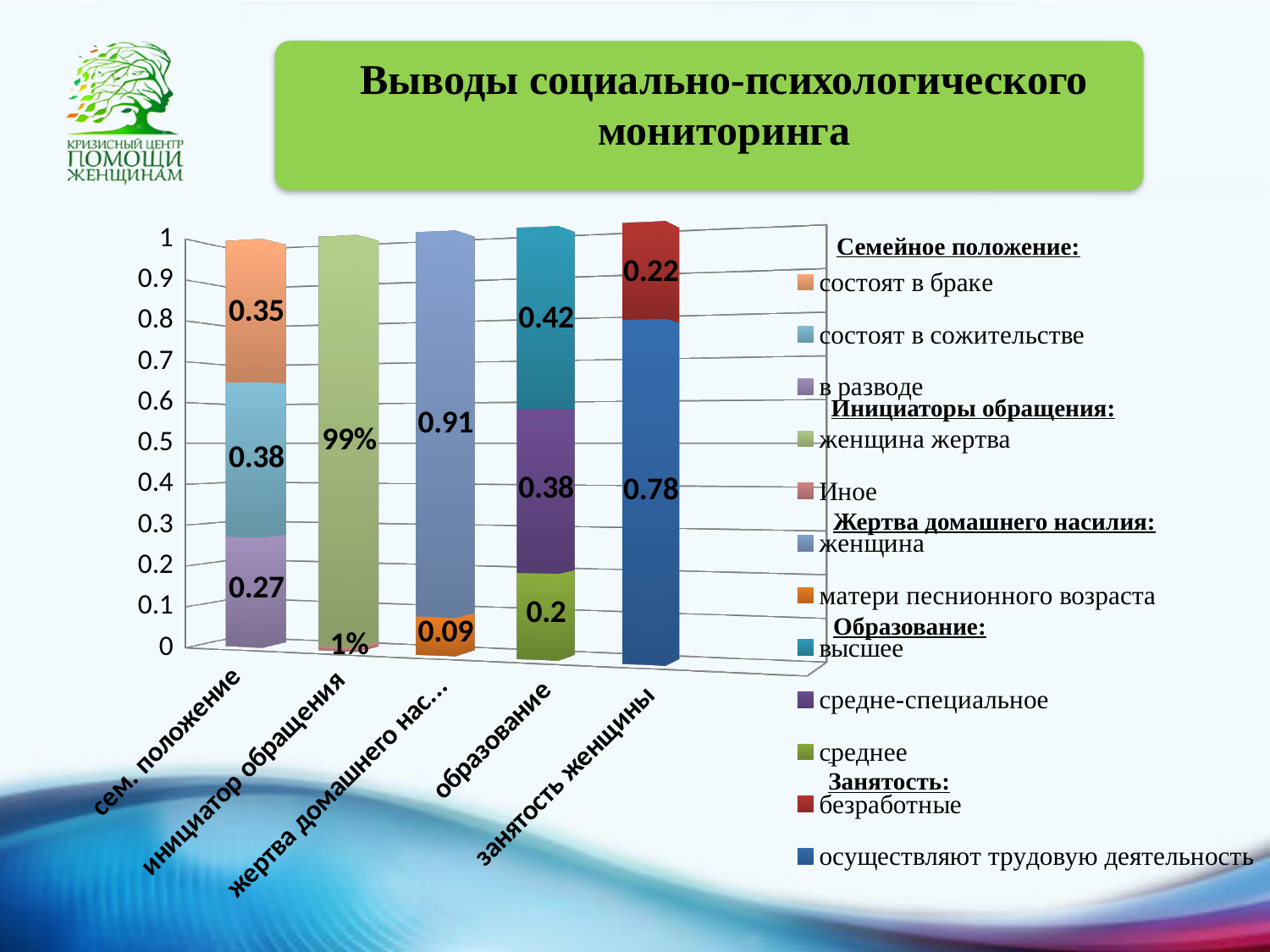
What is the value for 'Иное' in the 'инициатор обращения' bar? 1% What is the value for 'осуществляют трудовую деятельность' in the 'занятость женщины' bar? 0.78 Which segment is larger in the 'образование' bar: 'высшее' or 'среднее'? высшее What is the value for 'женщина жертва' in the 'инициатор обращения' bar? 99% How many categories are shown on the x axis of the chart? 5 What is the value for 'в разводе' in the 'сем. положение' bar? 0.27 What is the value for 'матери песнионного возраста' in the 'жертва домашнего нас...' bar? 0.09 What is the difference between 'осуществляют трудовую деятельность' (0.78) and 'безработные' (0.22) in the 'занятость женщины' bar? 0.56 What kind of chart is shown on the slide? stacked bar chart What is the value for 'высшее' in the 'образование' bar? 0.42 What is the value for 'состоят в браке' in the 'сем. положение' bar? 0.35 How many series does the chart legend list? 12